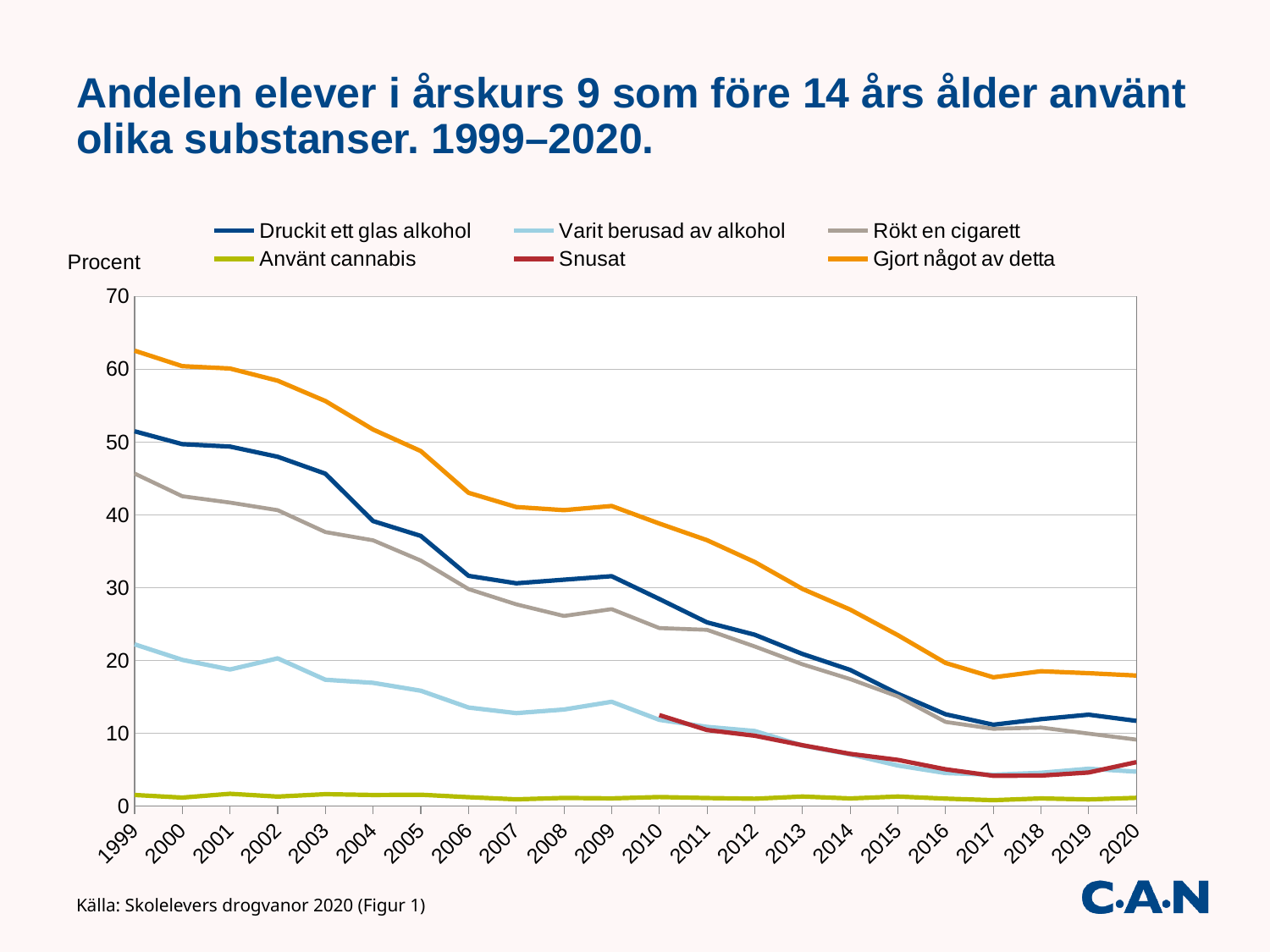
What kind of chart is shown on the slide? Line chart How many series does the legend list? 6 Is the value for 'Rökt en cigarett' in 1999 greater or less than 40? greater Is the value for 'Varit berusad av alkohol' in 2020 greater or less than 10? less In 1999, which is larger: 'Druckit ett glas alkohol' or 'Rökt en cigarett'? Druckit ett glas alkohol Which series has the highest values across the whole period? Gjort något av detta How many years are shown on the x axis? 22 What is the label on the vertical axis? Procent Which series has the lowest values across the whole period? Använt cannabis Is the value for 'Gjort något av detta' in 1999 greater or less than 60? greater What colour is the line for 'Gjort något av detta'? Orange Does the value for 'Gjort något av detta' rise or fall from 1999 to 2020? Fall